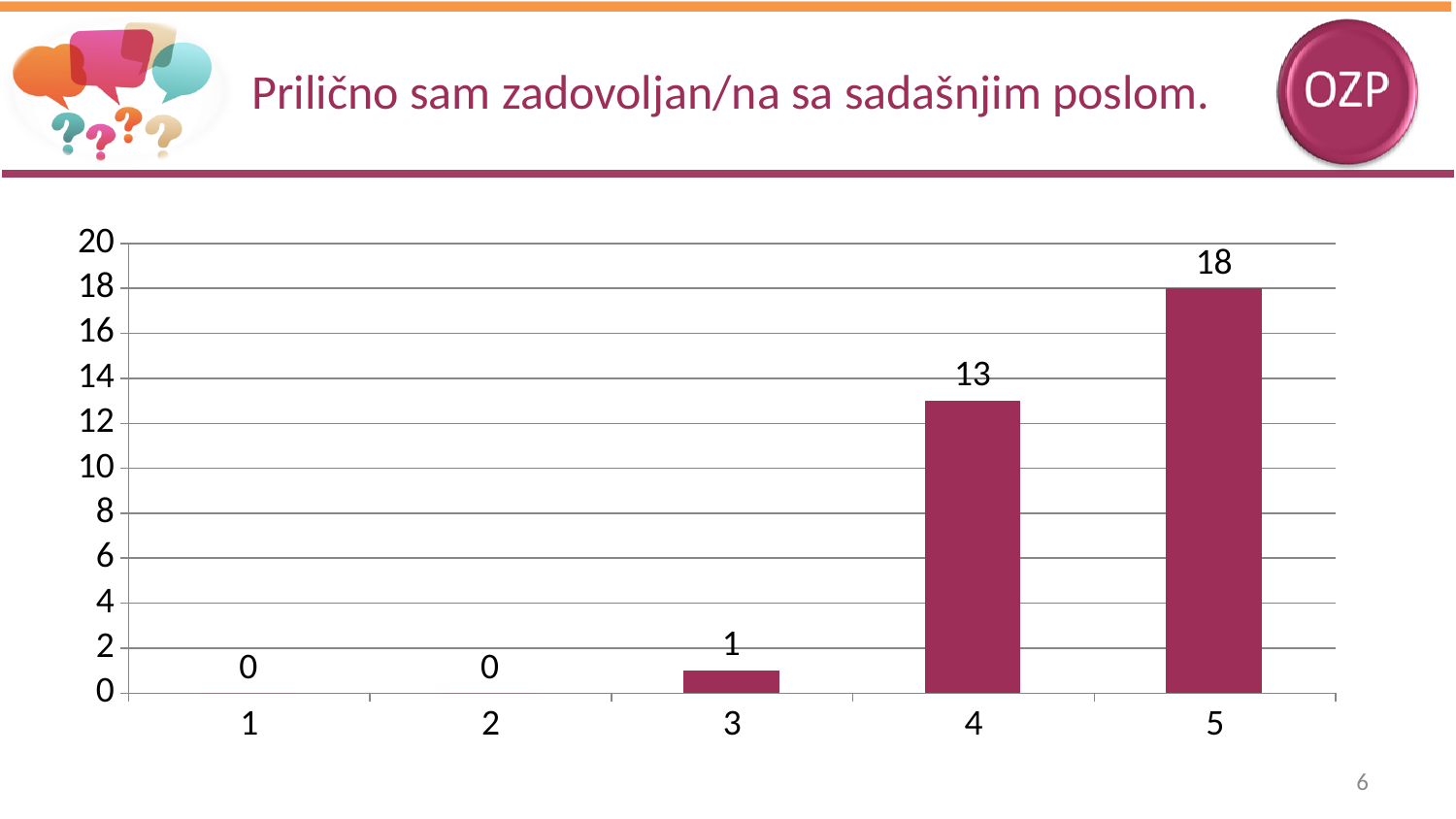
Do the values rise or fall from category 1 to category 5? rise What is the value for category 1? 0 What is the value for category 4? 13 Which is larger, the value for category 3 or the value for category 4? 4 How many categories are shown on the x axis? 5 Which category has the highest value? 5 What is the title of the slide above the chart? Prilično sam zadovoljan/na sa sadašnjim poslom. What is the value for category 5? 18 What kind of chart is shown on the slide? bar chart Is the value for category 4 greater or less than 10? greater What is the value for category 3? 1 What is the difference between the values for categories 5 and 4? 5